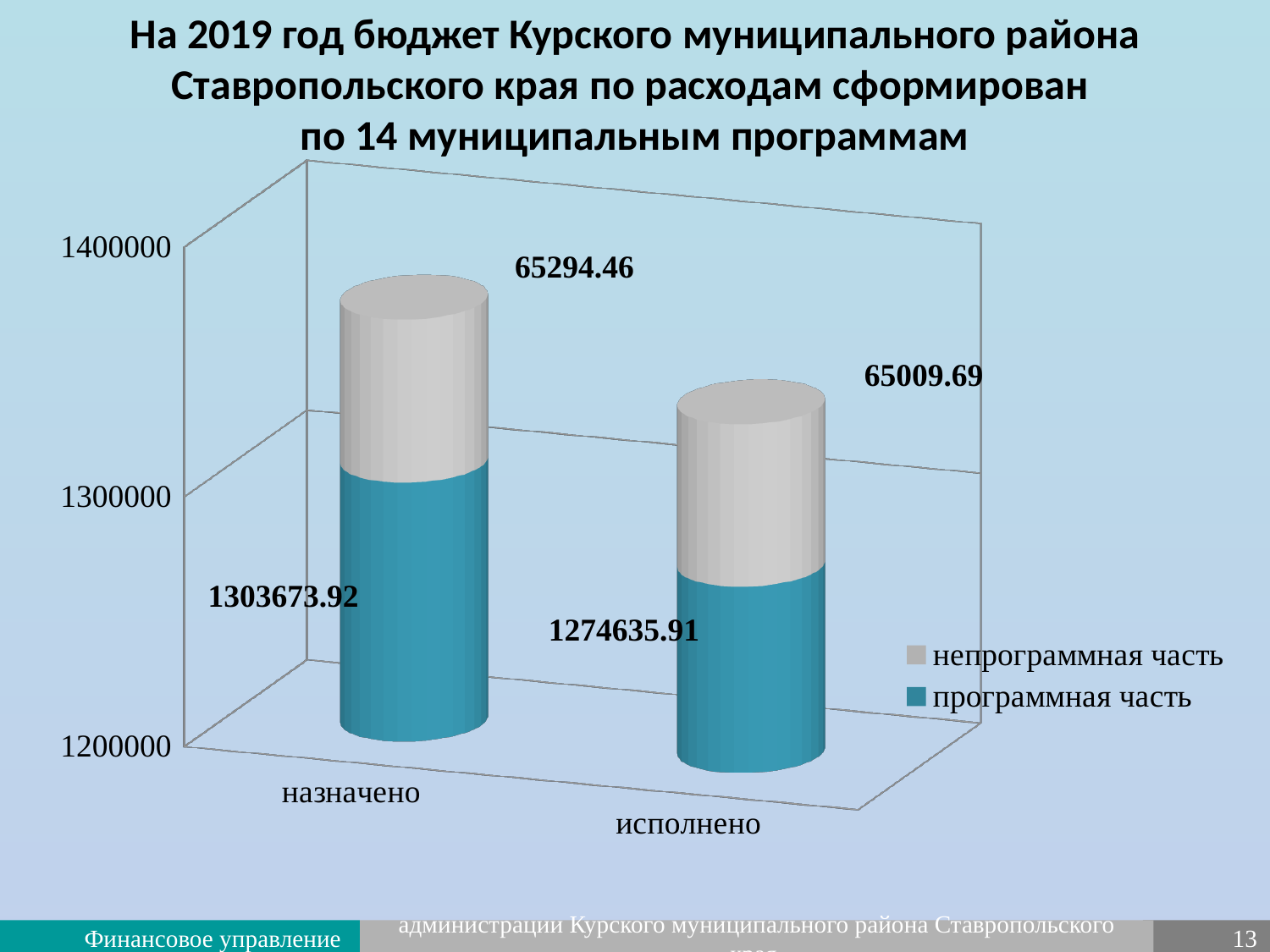
How many series does the legend list? 2 What is the difference between the непрограммная часть values for назначено and исполнено? 284.77 What kind of chart is shown on the slide? Stacked bar chart What is the value of the программная часть for назначено? 1303673.92 What is the value of the непрограммная часть for назначено? 65294.46 What is the total of the stacked bar for исполнено? 1339645.60 What is the value of the программная часть for исполнено? 1274635.91 What is the difference between the программная часть values for назначено and исполнено? 29038.01 How many categories are shown on the x axis? 2 What is the total of the stacked bar for назначено? 1368968.38 Which category has the higher value for the программная часть, назначено or исполнено? назначено What is the value of the непрограммная часть for исполнено? 65009.69